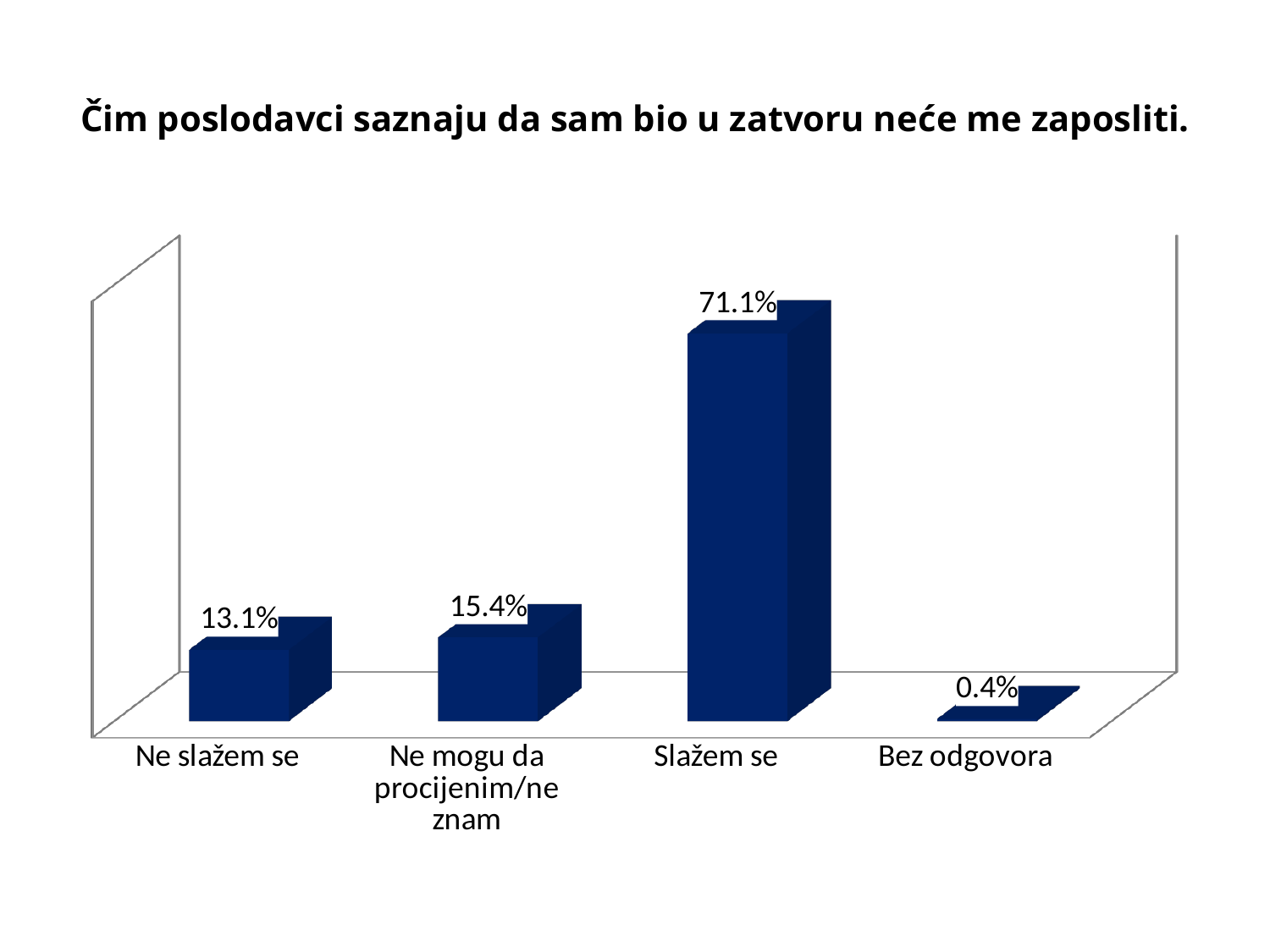
What is the value for "Ne mogu da procijenim/ne znam"? 15.4% What is the value for "Ne slažem se"? 13.1% What is the title of the chart? Čim poslodavci saznaju da sam bio u zatvoru neće me zaposliti. What is the value for "Bez odgovora"? 0.4% What is the difference between the values for "Slažem se" and "Ne slažem se"? 58.0% What kind of chart is shown on the slide? Bar chart What is the difference between the values for "Ne mogu da procijenim/ne znam" and "Ne slažem se"? 2.3% Which category has the highest value? Slažem se How many categories are shown in the chart? 4 What is the value for "Slažem se"? 71.1% Which category has the lowest value? Bez odgovora Which is larger, the value for "Ne slažem se" or the value for "Ne mogu da procijenim/ne znam"? Ne mogu da procijenim/ne znam